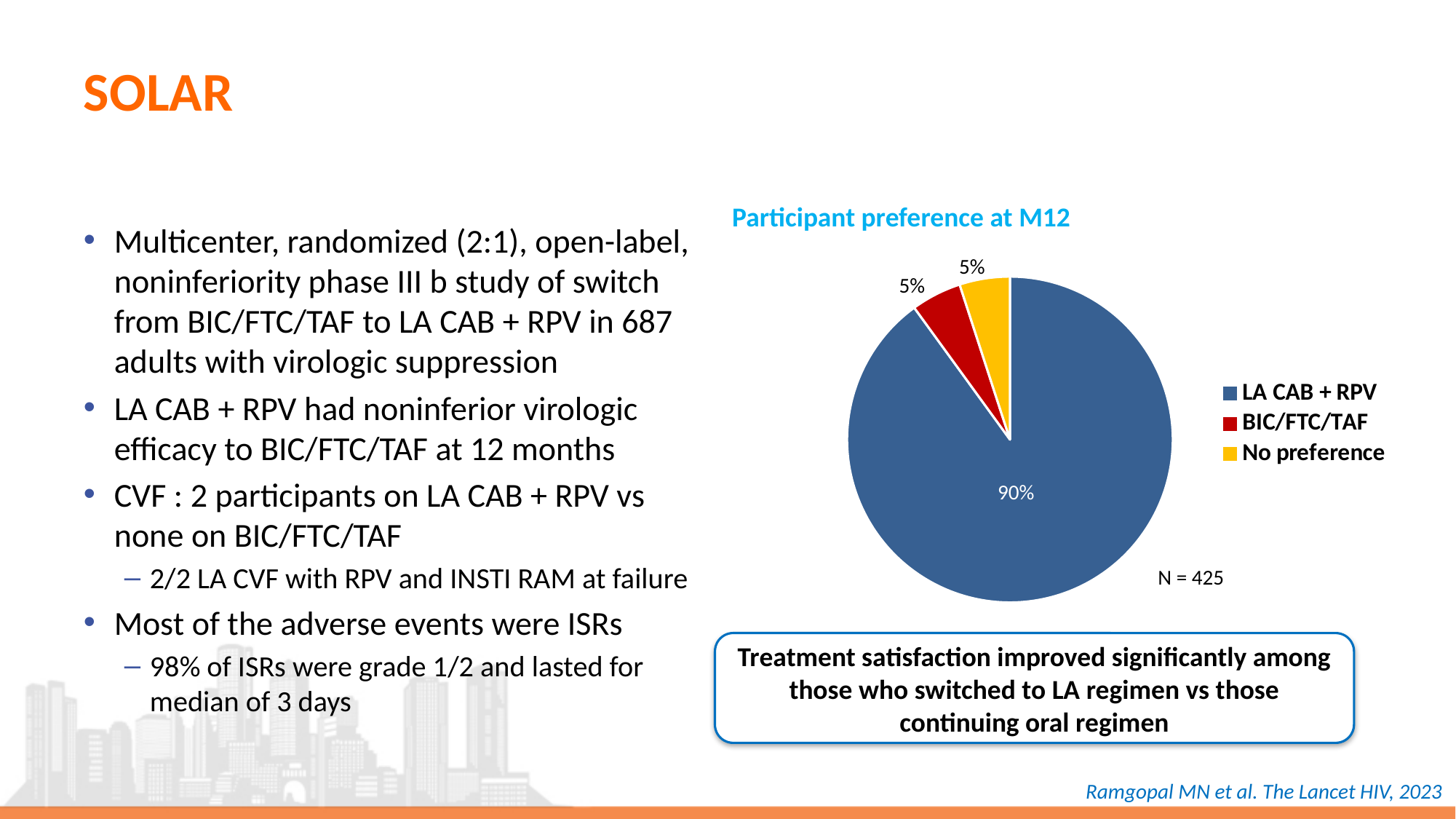
What kind of chart is shown on the slide? pie chart Which category has the largest slice of the pie? LA CAB + RPV Which is larger, the share for LA CAB + RPV or the share for No preference? LA CAB + RPV What is the title of the chart? Participant preference at M12 What is the combined share of BIC/FTC/TAF and No preference? 10% How many categories does the legend list? 3 What share of participants preferred BIC/FTC/TAF? 5% What is the N shown next to the pie chart? N = 425 What share of participants had no preference? 5% What share of participants preferred LA CAB + RPV? 90% What is the difference between the share for LA CAB + RPV and the share for BIC/FTC/TAF? 85%